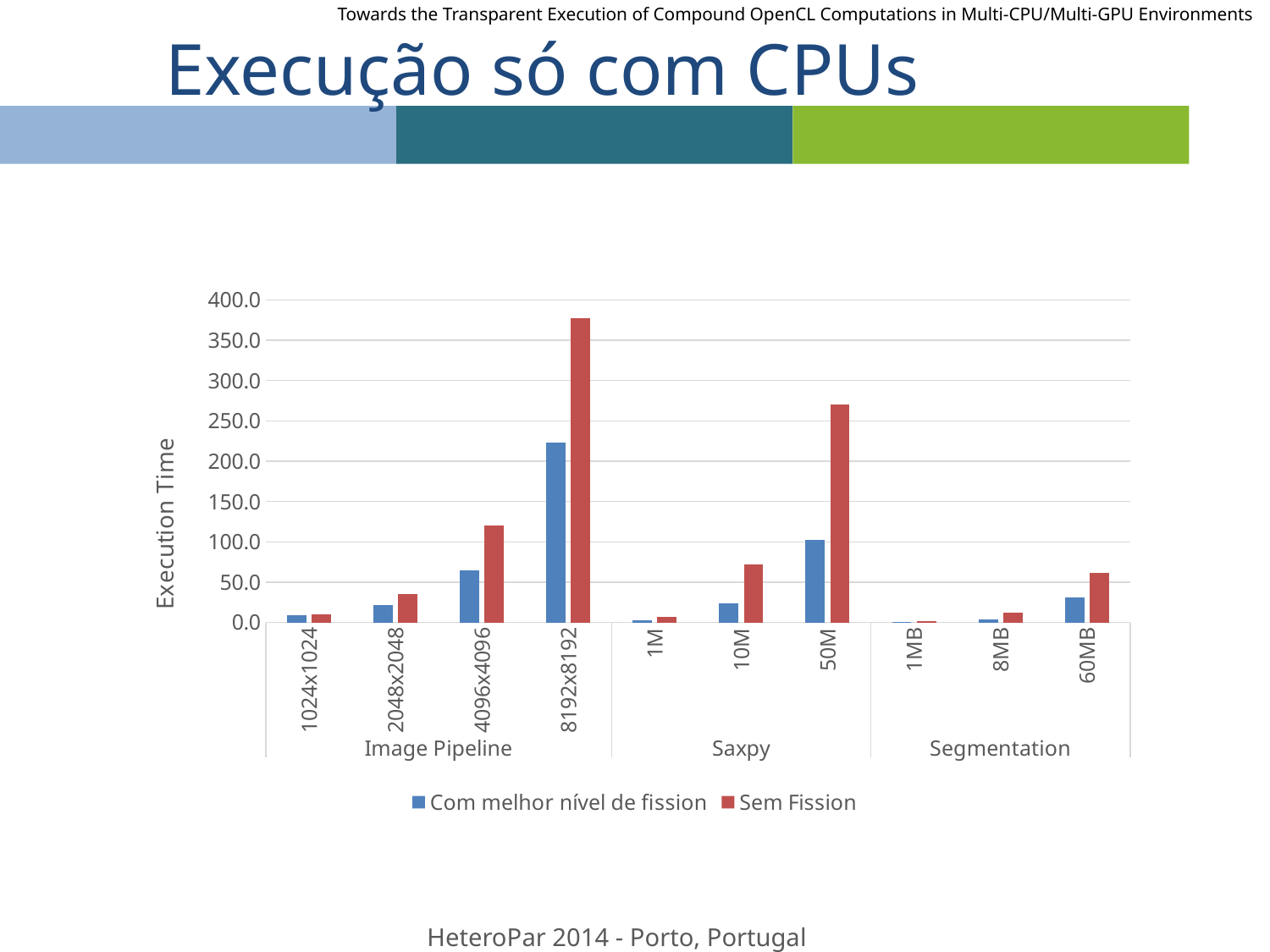
Is the Sem Fission value for 8192x8192 greater or less than 350? greater Is the Com melhor nível de fission value for 50M greater or less than 150? less Which category has the highest Sem Fission bar? 8192x8192 Within the Image Pipeline group, do the Sem Fission values rise or fall from 1024x1024 to 8192x8192? rise What is the label of the vertical axis? Execution Time Which series is shown in red in the legend? Sem Fission What kind of chart is shown on the slide? bar chart Is the Sem Fission value for 50M greater or less than 250? greater How many categories are plotted along the x axis? 10 For 4096x4096, which series has the larger value, Com melhor nível de fission or Sem Fission? Sem Fission How many series does the legend list? 2